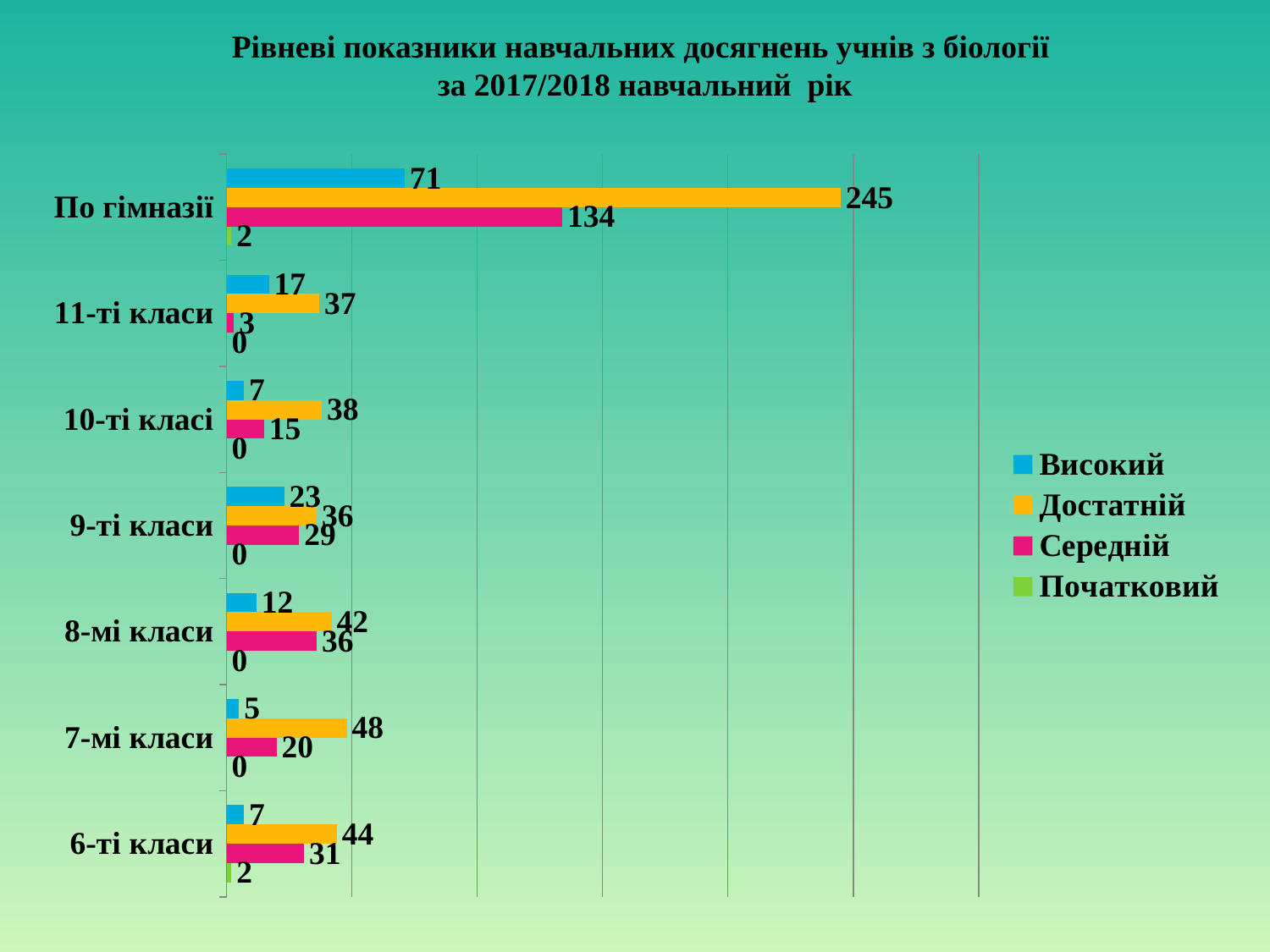
What is the difference between the Достатній and Середній values for По гімназії? 111 What is the total of all four series for 10-ті класі? 60 What is the value of Середній for 9-ті класи? 29 Among the class categories (excluding По гімназії), which has the highest Достатній value? 7-мі класи How many series does the legend list? 4 What type of chart is shown on the slide? bar chart Which is larger for 8-мі класи: the Достатній value or the Середній value? Достатній What is the value of Початковий for 6-ті класи? 2 Among the class categories (excluding По гімназії), which has the lowest Середній value? 11-ті класи How many categories are shown on the chart? 7 What is the value of Високий for 11-ті класи? 17 What is the value of Достатній for По гімназії? 245